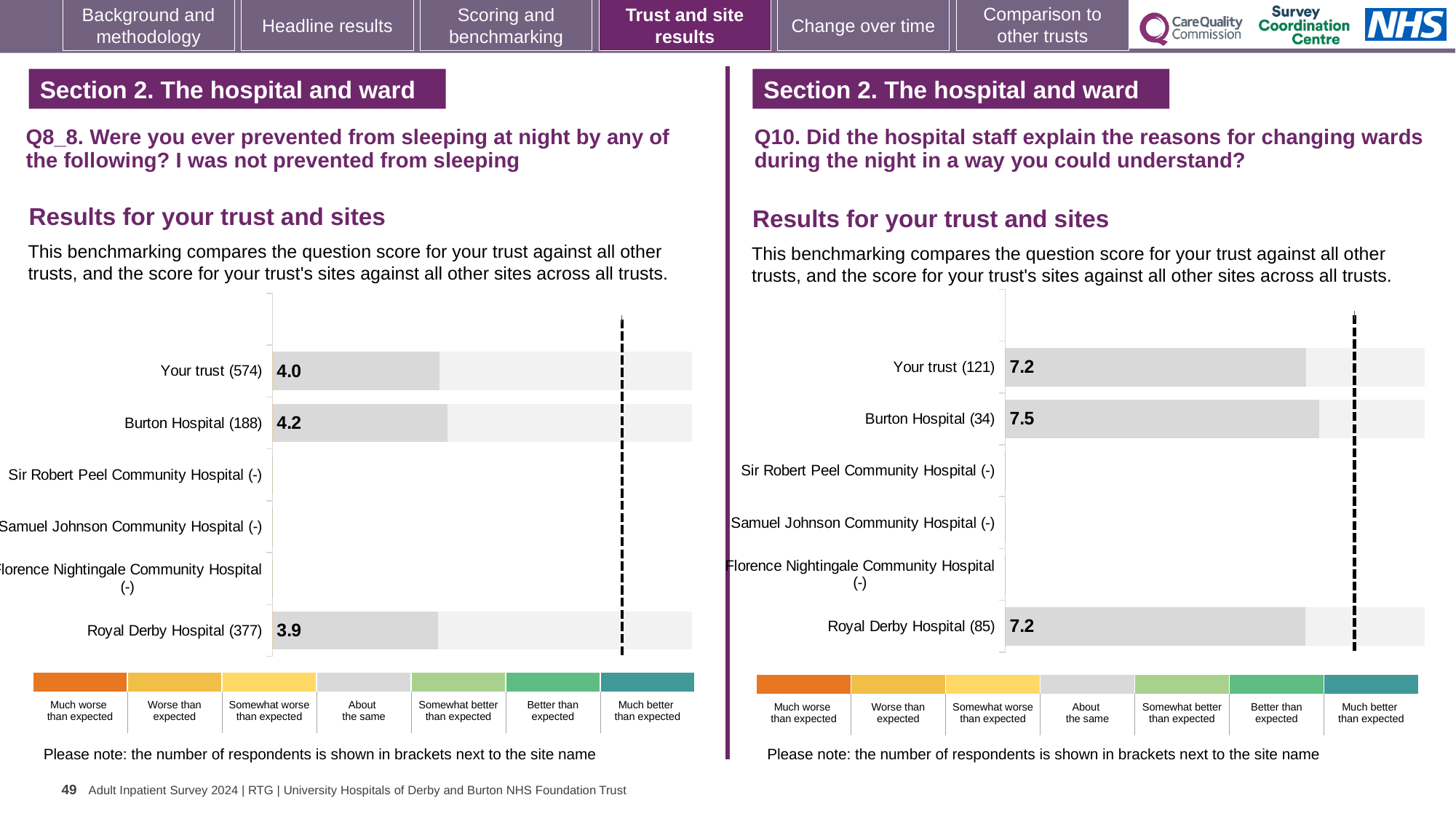
On the right chart (Q10), what is the score for Burton Hospital? 7.5 On the left chart (Q8_8), what is the score for Burton Hospital? 4.2 On the right chart (Q10), how many respondents are shown for Your trust? 121 On the left chart (Q8_8), how many sites have a score bar plotted? 3 On the right chart (Q10), what is the difference between the scores for Burton Hospital and Your trust? 0.3 On the right chart (Q10), which site has the highest score? Burton Hospital On the left chart (Q8_8), what is the difference between the scores for Burton Hospital and Royal Derby Hospital? 0.3 On the left chart (Q8_8), what is the score for Royal Derby Hospital? 3.9 On the left chart (Q8_8), which site has the highest score? Burton Hospital What type of chart is used on the left (Q8_8)? Bar chart On the right chart (Q10), what is the score for Royal Derby Hospital? 7.2 On the left chart (Q8_8), what is the score for Your trust? 4.0